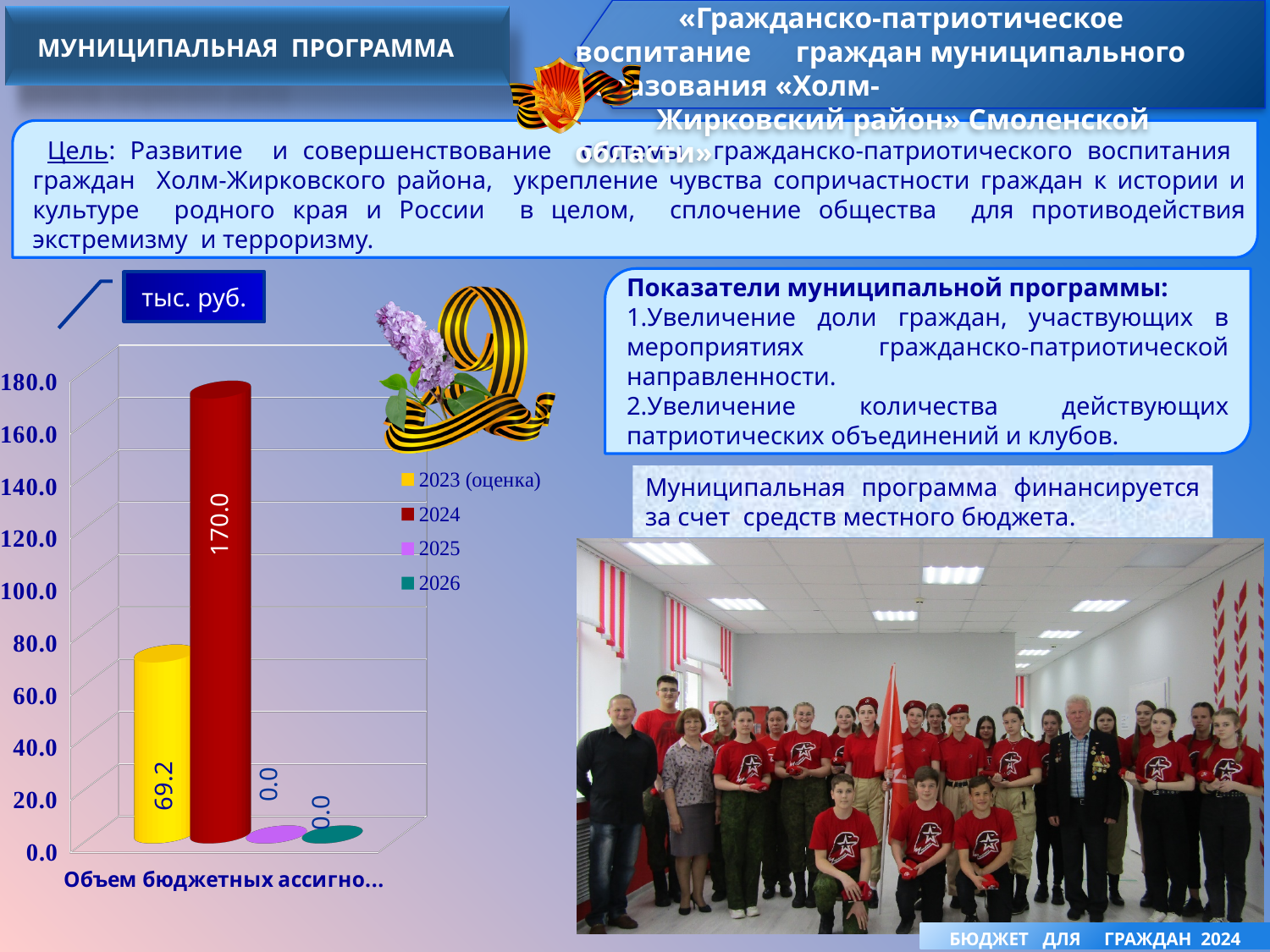
What is the value for 2026 on the chart? 0.0 What unit is shown in the label above the chart? тыс. руб. Is the value for 2023 (оценка) greater or less than 80.0? less What kind of chart is shown on the slide? Bar chart What is the value for 2024 on the chart? 170.0 Which is larger, the value for 2023 (оценка) or the value for 2024? 2024 What is the value for 2025 on the chart? 0.0 What is the value for 2023 (оценка) on the chart? 69.2 Is the value for 2024 greater or less than 160.0? greater How many series does the chart legend list? 4 Which year has the highest value on the chart? 2024 What is the difference between the values for 2024 and 2023 (оценка)? 100.8